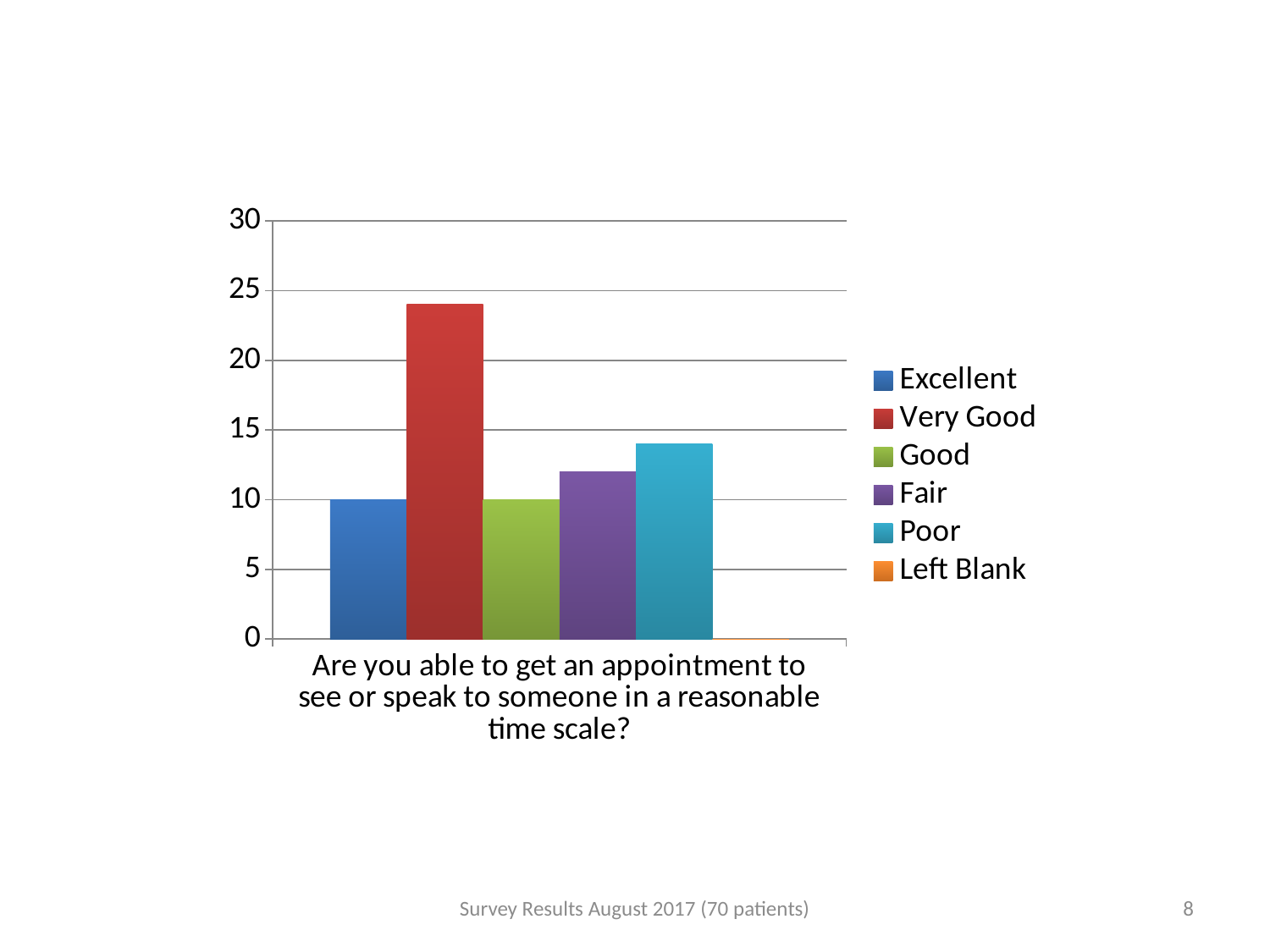
Is the value for Poor greater or less than 15? less Which is larger, the value for Poor or the value for Excellent? Poor Which response has the lowest value? Left Blank What kind of chart is shown on the slide? bar chart What is the value for Excellent? 10 How many series does the legend list? 6 Which is larger, the value for Very Good or the value for Fair? Very Good Is the value for Fair greater or less than 10? greater What is the value for Good? 10 What question is shown as the category label on the x axis? Are you able to get an appointment to see or speak to someone in a reasonable time scale? Is the value for Very Good greater or less than 20? greater Which response has the highest value? Very Good